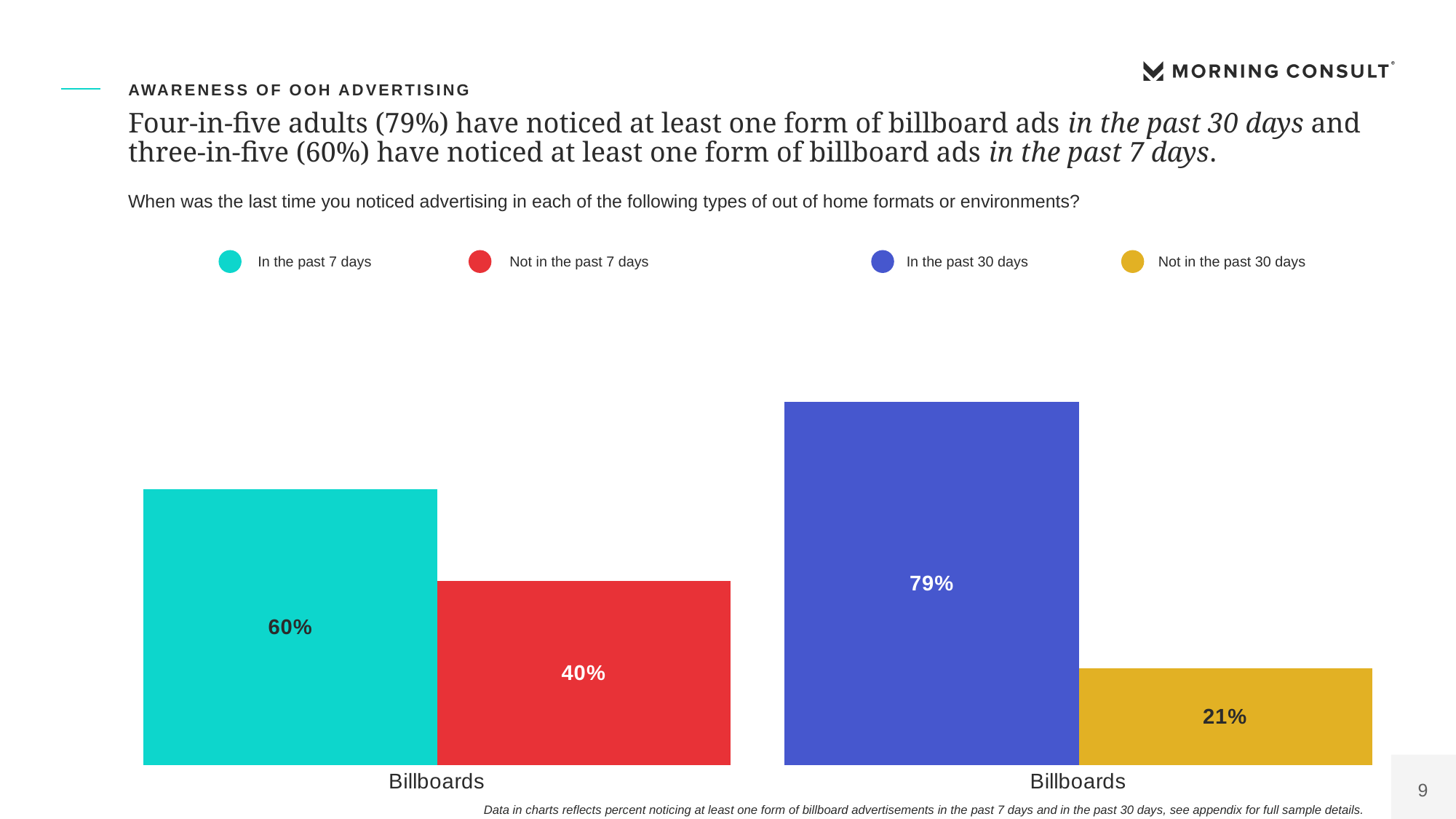
How many entries does the legend list? 4 In the left chart, what is the value for 'Not in the past 7 days' for Billboards? 40% In the right chart, what is the difference between 'In the past 30 days' and 'Not in the past 30 days'? 58% In the left chart, what percentage of adults noticed billboard ads in the past 7 days? 60% Across both charts, which series has the highest value? In the past 30 days In the right chart, what percentage of adults noticed billboard ads in the past 30 days? 79% What type of chart is shown on the slide? Bar chart Across both charts, which series has the lowest value? Not in the past 30 days In the right chart, what is the value for 'Not in the past 30 days' for Billboards? 21% In the left chart, what is the difference between 'In the past 7 days' and 'Not in the past 7 days'? 20% What colour is the bar for 'In the past 30 days' in the right chart? Blue Which is larger: the 'In the past 7 days' value in the left chart or the 'In the past 30 days' value in the right chart? In the past 30 days